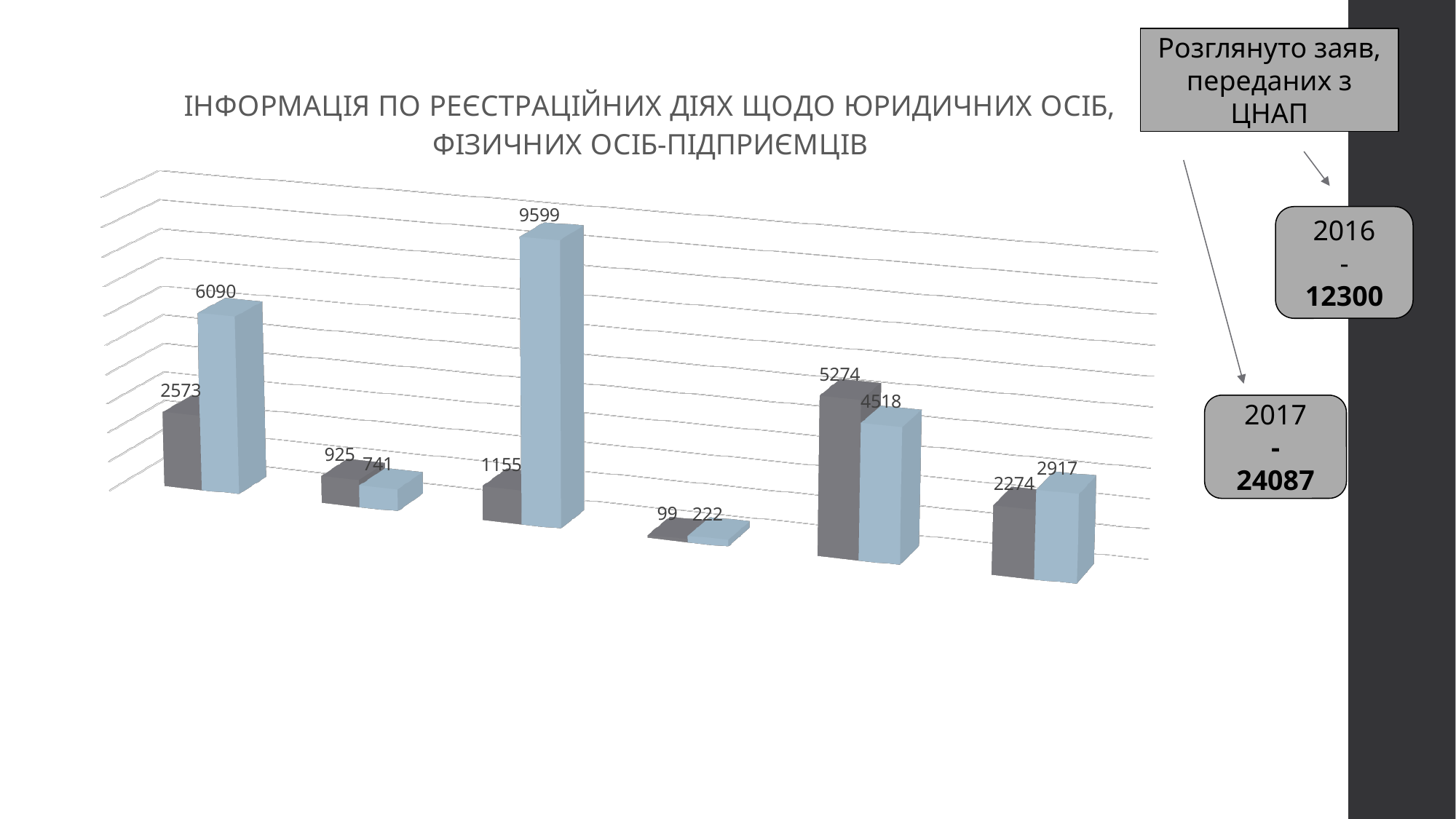
In the fifth group of bars, which is larger: the dark grey bar or the light blue bar? the dark grey bar (5274) What is the highest value labelled on the chart? 9599 What is the lowest value labelled on the chart? 99 What is the title of the chart? ІНФОРМАЦІЯ ПО РЕЄСТРАЦІЙНИХ ДІЯХ ЩОДО ЮРИДИЧНИХ ОСІБ, ФІЗИЧНИХ ОСІБ-ПІДПРИЄМЦІВ What kind of chart is shown on the slide? bar chart What is the value of the light blue bar in the third group of bars? 9599 What is the difference between the light blue bar (2917) and the dark grey bar (2274) in the sixth (rightmost) group? 643 What is the difference between the light blue bar (9599) and the dark grey bar (1155) in the third group? 8444 What is the value of the dark grey bar in the fifth group of bars? 5274 What is the value of the light blue bar in the first group of bars (leftmost)? 6090 What is the value of the dark grey bar in the first group of bars (leftmost)? 2573 How many groups of bars does the chart contain? 6